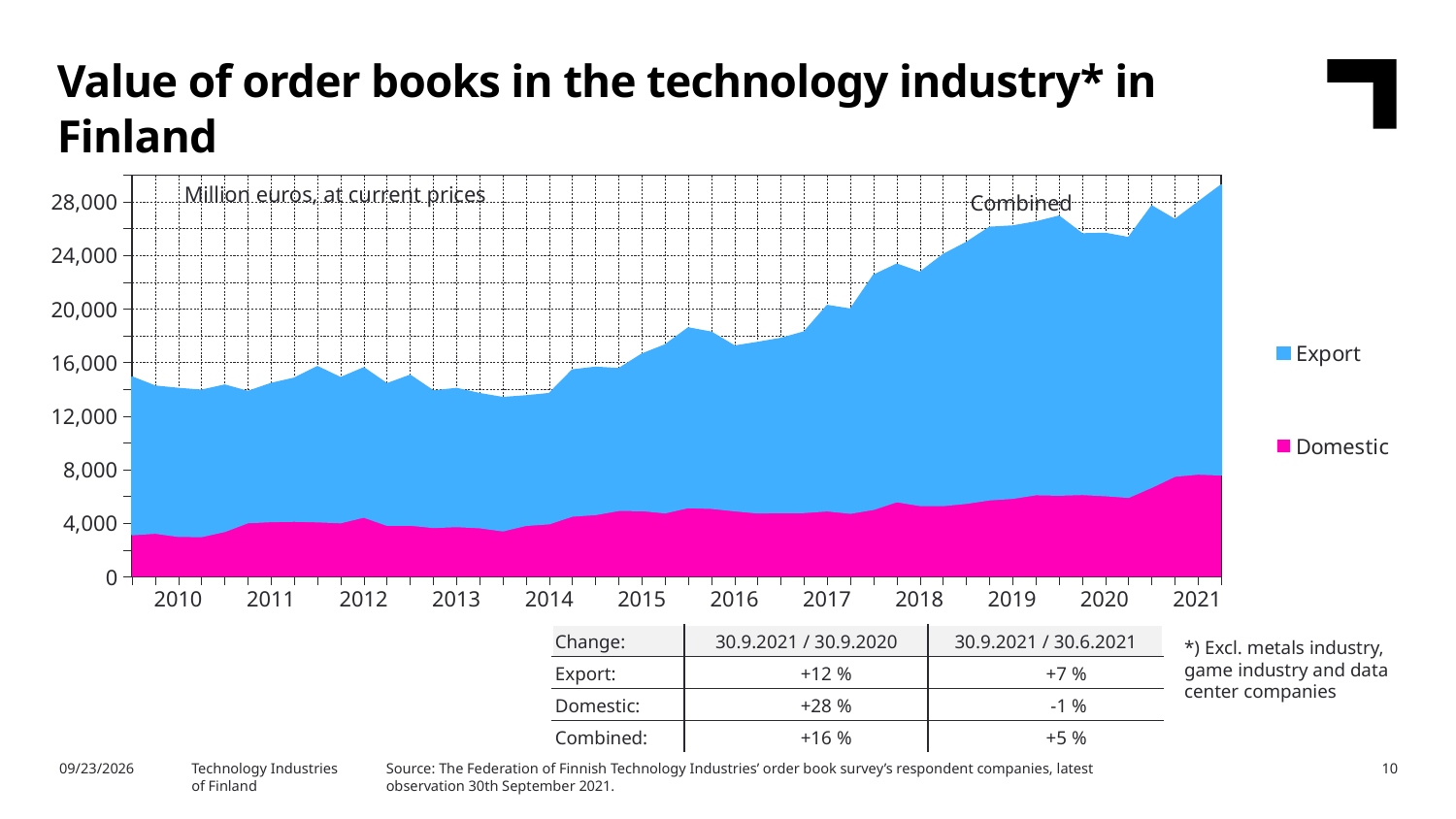
Is the Domestic value at the start of 2010 greater or less than 4,000? less Is the combined value at the start of 2010 greater or less than 16,000? less How many years are labelled on the x axis? 12 How many series does the legend list? 2 What kind of chart is shown on the slide? Stacked area chart In which year does the combined value reach its highest level? 2021 What unit is stated for the values in the chart? Million euros, at current prices Which two series are shown in the legend? Export and Domestic Is the combined value at the end of 2021 greater or less than 28,000? greater Does the combined value rise or fall from 2018 to 2021? rise Which series is larger in 2021, Export or Domestic? Export